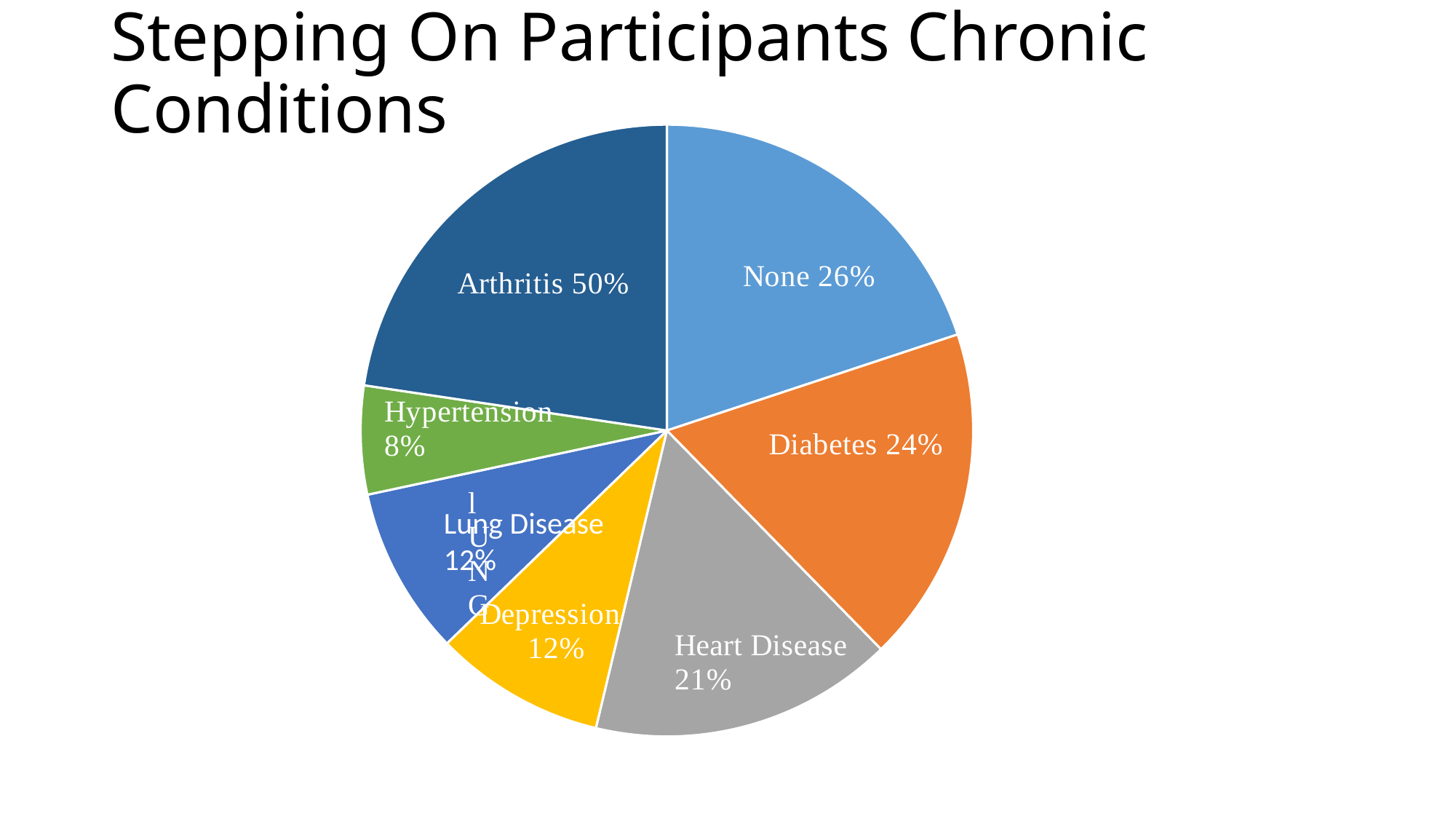
What kind of chart is shown on the slide? pie chart Which condition has the largest slice of the pie? Arthritis What percentage is shown for Hypertension? 8% How many slices does the pie chart have? 7 Which condition has the smallest slice of the pie? Hypertension What percentage is shown for Heart Disease? 21% What percentage is shown for None? 26% What is the difference between the percentages shown for Arthritis and Heart Disease? 29% What is the title of the chart on the slide? Stepping On Participants Chronic Conditions What is the difference between the percentages shown for None and Diabetes? 2% Which is larger, the percentage for Diabetes or the percentage for Heart Disease? Diabetes What percentage is shown for Arthritis? 50%